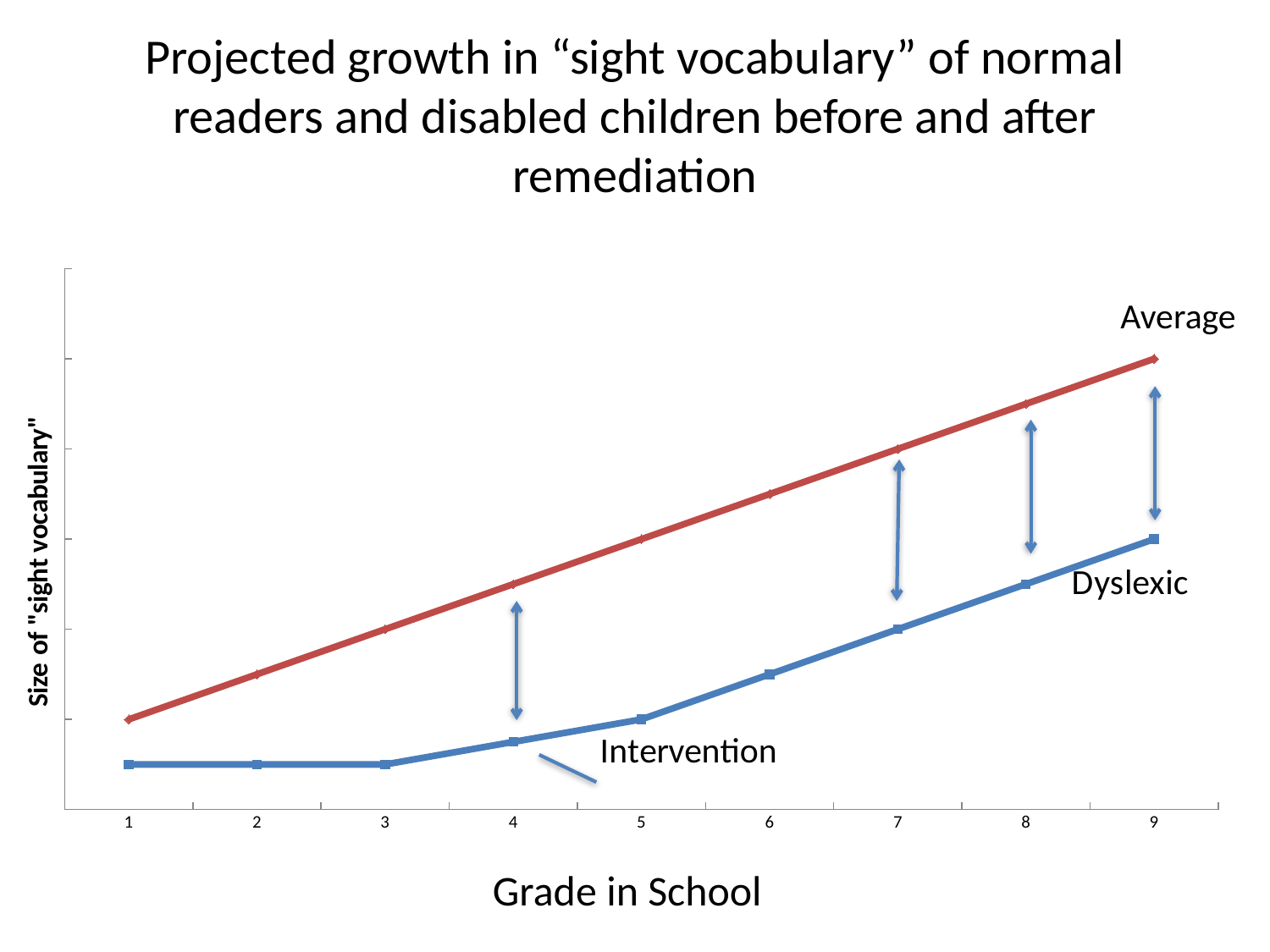
What is the label of the x axis? Grade in School How many series are plotted on the chart? 2 How many grade levels are shown along the x axis? 9 At grade 9, which line is higher, Average or Dyslexic? Average What kind of chart is shown on the slide? Line chart At which grade does the Average line reach its highest value? 9 What are the names of the two lines plotted on the chart? Average and Dyslexic Does the Average line rise or fall as grade in school increases? Rises At grade 4, which line is lower, Average or Dyslexic? Dyslexic Does the Dyslexic line rise or fall between grade 5 and grade 9? Rises At which grade does the Dyslexic line reach its highest value? 9 At which grade does the Dyslexic line first begin to rise after being flat? 4